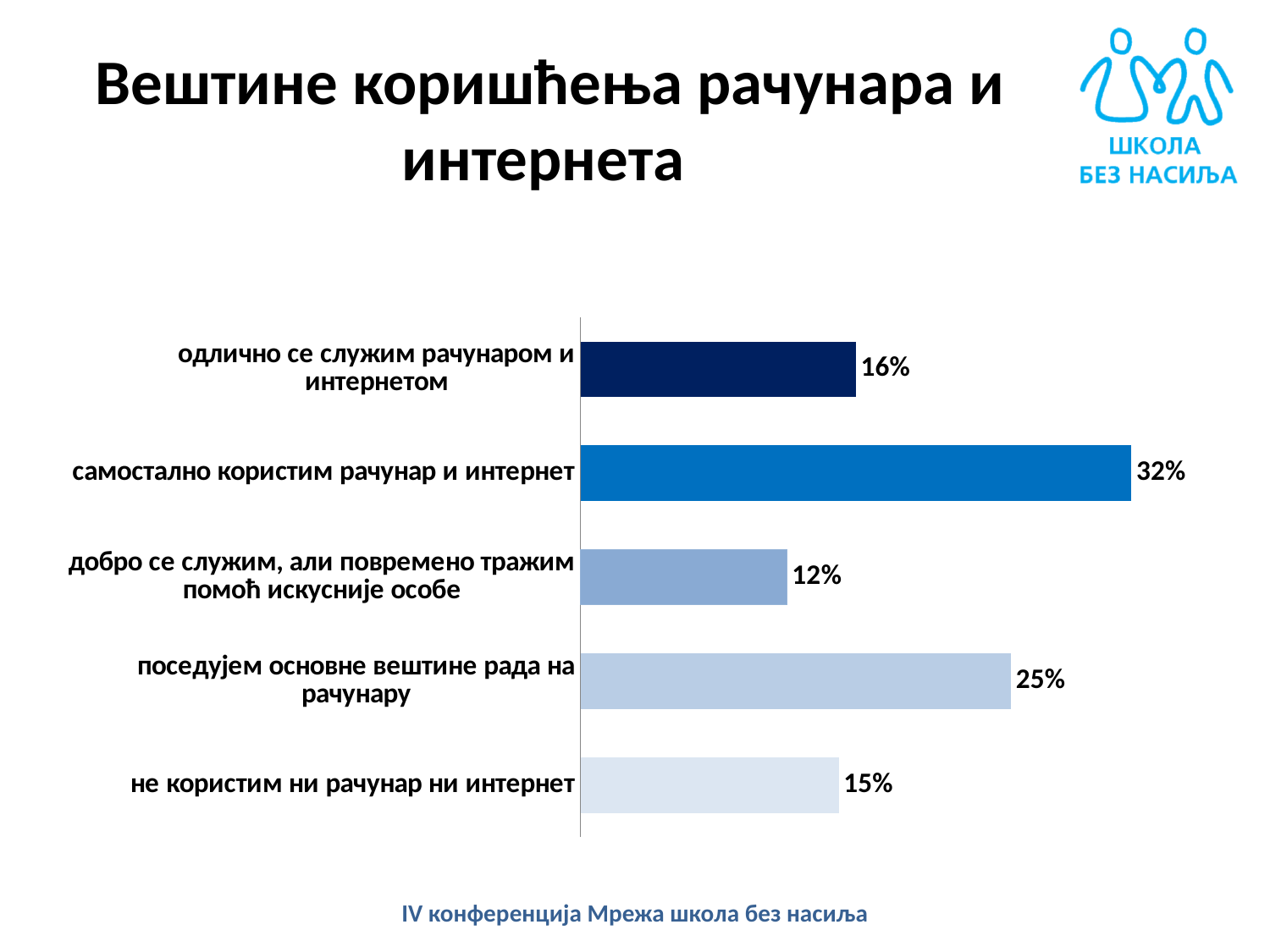
What is the difference between the values for "одлично се служим рачунаром и интернетом" and "добро се служим, али повремено тражим помоћ искусније особе"? 4% What is the value for "одлично се служим рачунаром и интернетом"? 16% How many categories are shown in the chart? 5 What is the title of the slide containing the chart? Вештине коришћења рачунара и интернета Which category has the highest value? самостално користим рачунар и интернет What is the difference between the values for "самостално користим рачунар и интернет" and "поседујем основне вештине рада на рачунару"? 7% What is the value for "не користим ни рачунар ни интернет"? 15% Which category has the lowest value? добро се служим, али повремено тражим помоћ искусније особе What is the value for "поседујем основне вештине рада на рачунару"? 25% Which is larger: the value for "поседујем основне вештине рада на рачунару" or the value for "не користим ни рачунар ни интернет"? поседујем основне вештине рада на рачунару What kind of chart is shown on the slide? bar chart What is the value for "самостално користим рачунар и интернет"? 32%